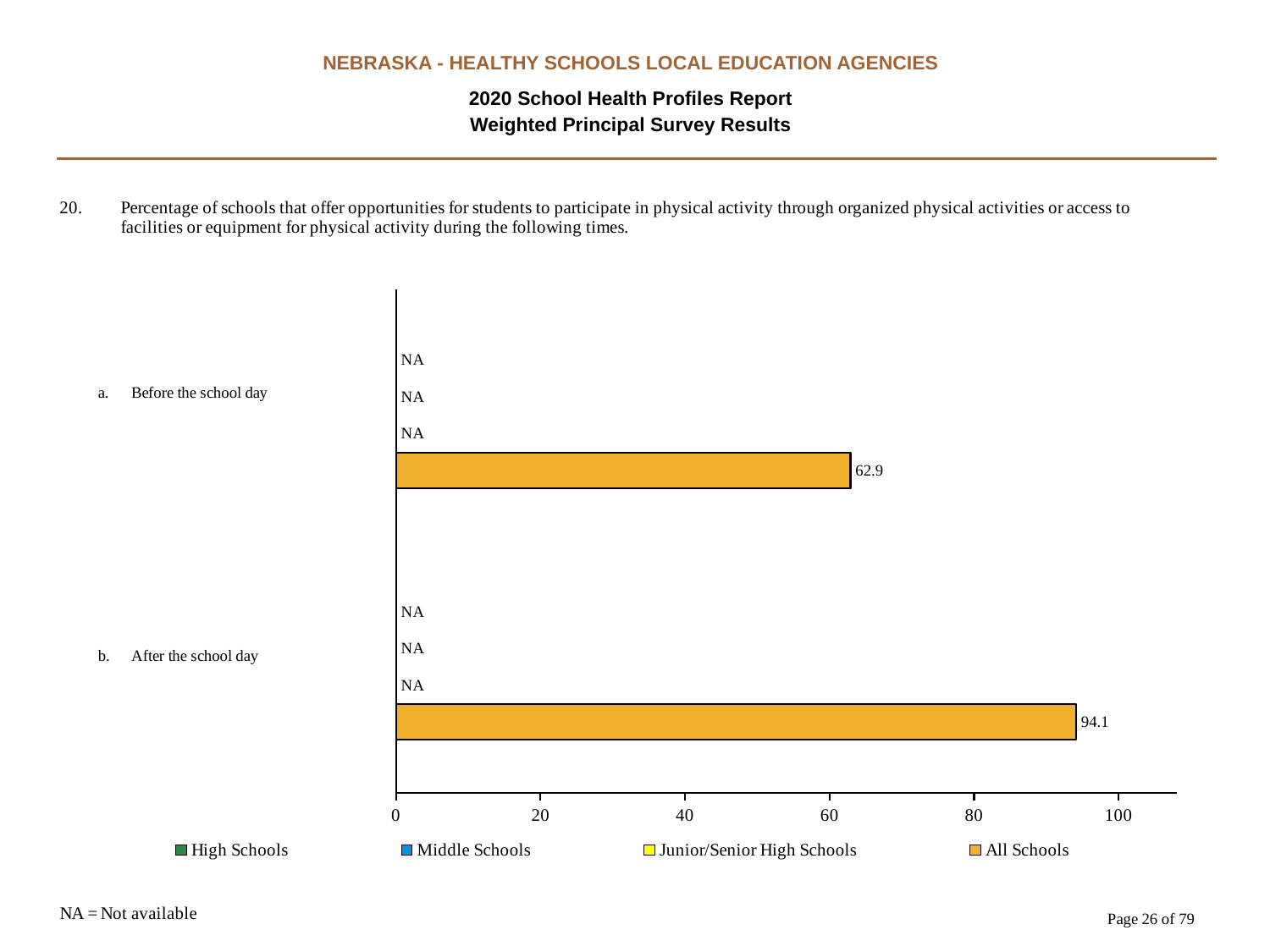
How many categories are shown on the chart? 2 What is the value for All Schools for 'After the school day'? 94.1 What value is shown for High Schools for 'Before the school day'? NA What is the difference between the All Schools values for 'After the school day' and 'Before the school day'? 31.2 How many series does the legend list? 4 Which series is shown in the legend with an orange/gold colour? All Schools What is the value for All Schools for 'Before the school day'? 62.9 What value is shown for Middle Schools for 'After the school day'? NA Which category has the higher All Schools value, 'Before the school day' or 'After the school day'? After the school day What kind of chart is shown on the slide? Bar chart Is the All Schools value for 'Before the school day' greater or less than 60? greater Is the All Schools value for 'After the school day' greater or less than 80? greater